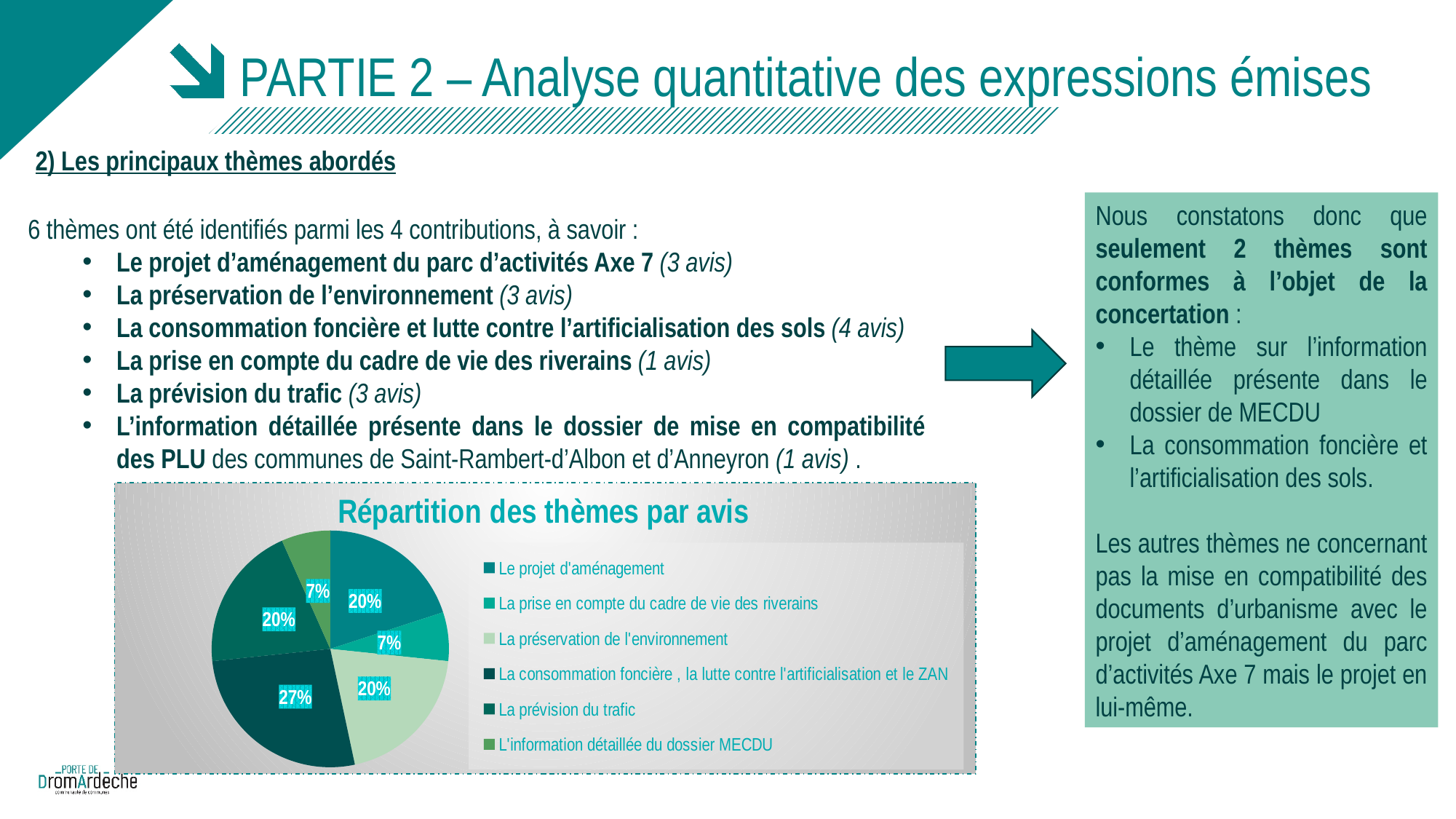
How many slices does the pie chart have? 6 What type of chart is shown on the slide? pie chart What share of the pie does 'L'information détaillée du dossier MECDU' represent? 7% What share of the pie does 'La consommation foncière , la lutte contre l'artificialisation et le ZAN' represent? 27% Which is larger in the pie chart: 'La préservation de l'environnement' or 'La prise en compte du cadre de vie des riverains'? La préservation de l'environnement What share of the pie does 'Le projet d'aménagement' represent? 20% What is the difference in percentage points between the largest slice (27%) and 'La prévision du trafic' (20%)? 7 What is the title of the chart on the slide? Répartition des thèmes par avis How many entries does the legend of the pie chart list? 6 How many slices in the pie chart are labelled 20%? 3 Which theme has the largest slice in the pie chart? La consommation foncière , la lutte contre l'artificialisation et le ZAN